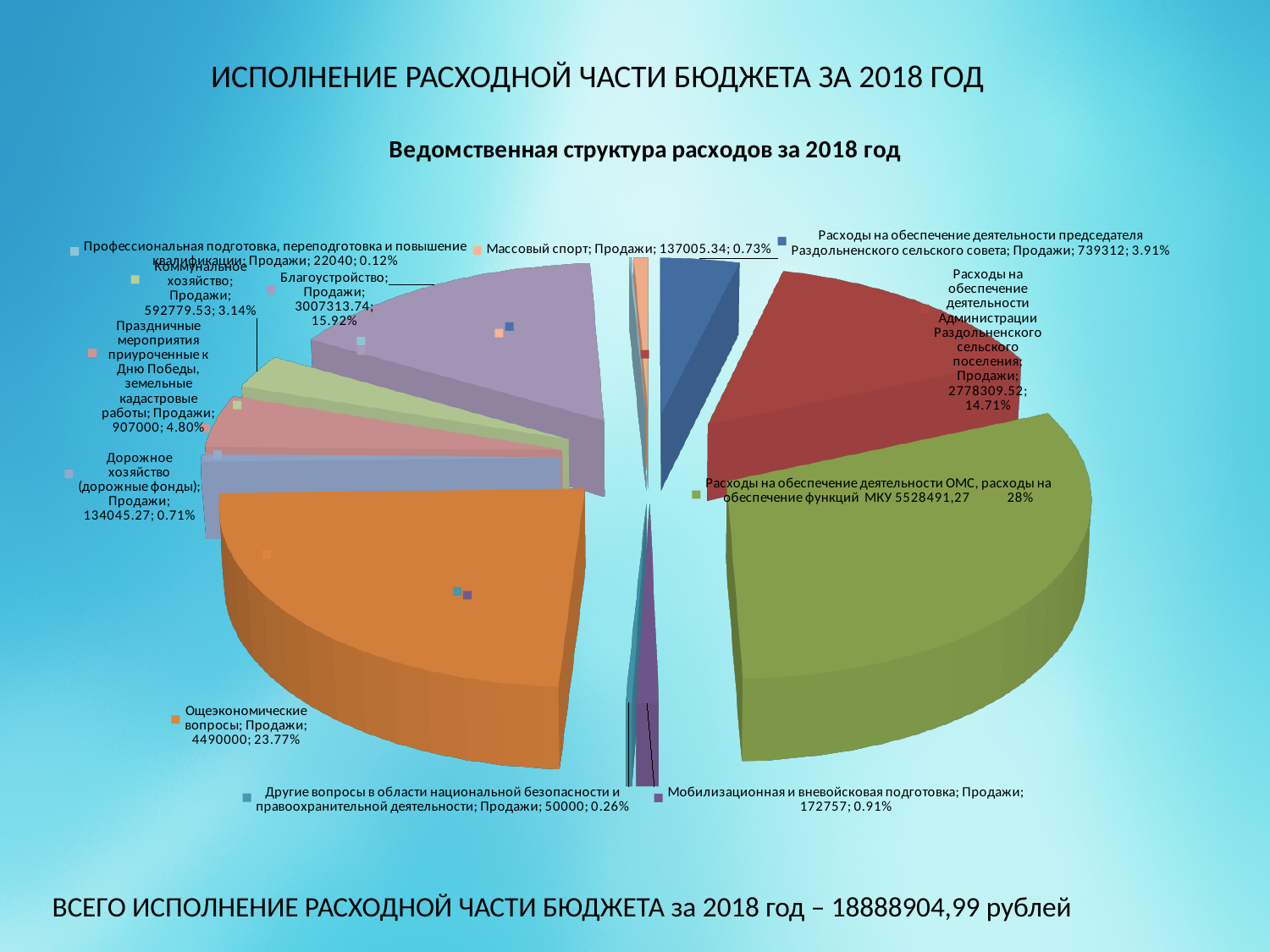
Which is larger: the share for "Благоустройство" or the share for "Расходы на обеспечение деятельности Администрации Раздольненского сельского поселения"? Благоустройство What kind of chart is shown on the slide? pie chart How many categories are shown in the pie chart? 12 What is the difference in percentage points between the share for "Благоустройство" (15.92%) and the share for "Расходы на обеспечение деятельности Администрации Раздольненского сельского поселения" (14.71%)? 1.21 What is the value shown for "Ощеэкономические вопросы"? 4490000 What is the title of the chart? Ведомственная структура расходов за 2018 год What is the value shown for "Массовый спорт"? 137005.34 What is the value shown for "Коммунальное хозяйство"? 592779.53 What share of the pie does "Благоустройство" account for? 15.92% Which category has the smallest share of the pie? Профессиональная подготовка, переподготовка и повышение квалификации Which category has the largest share of the pie? Расходы на обеспечение деятельности ОМС, расходы на обеспечение функций МКУ What share of the pie does "Мобилизационная и вневойсковая подготовка" account for? 0.91%